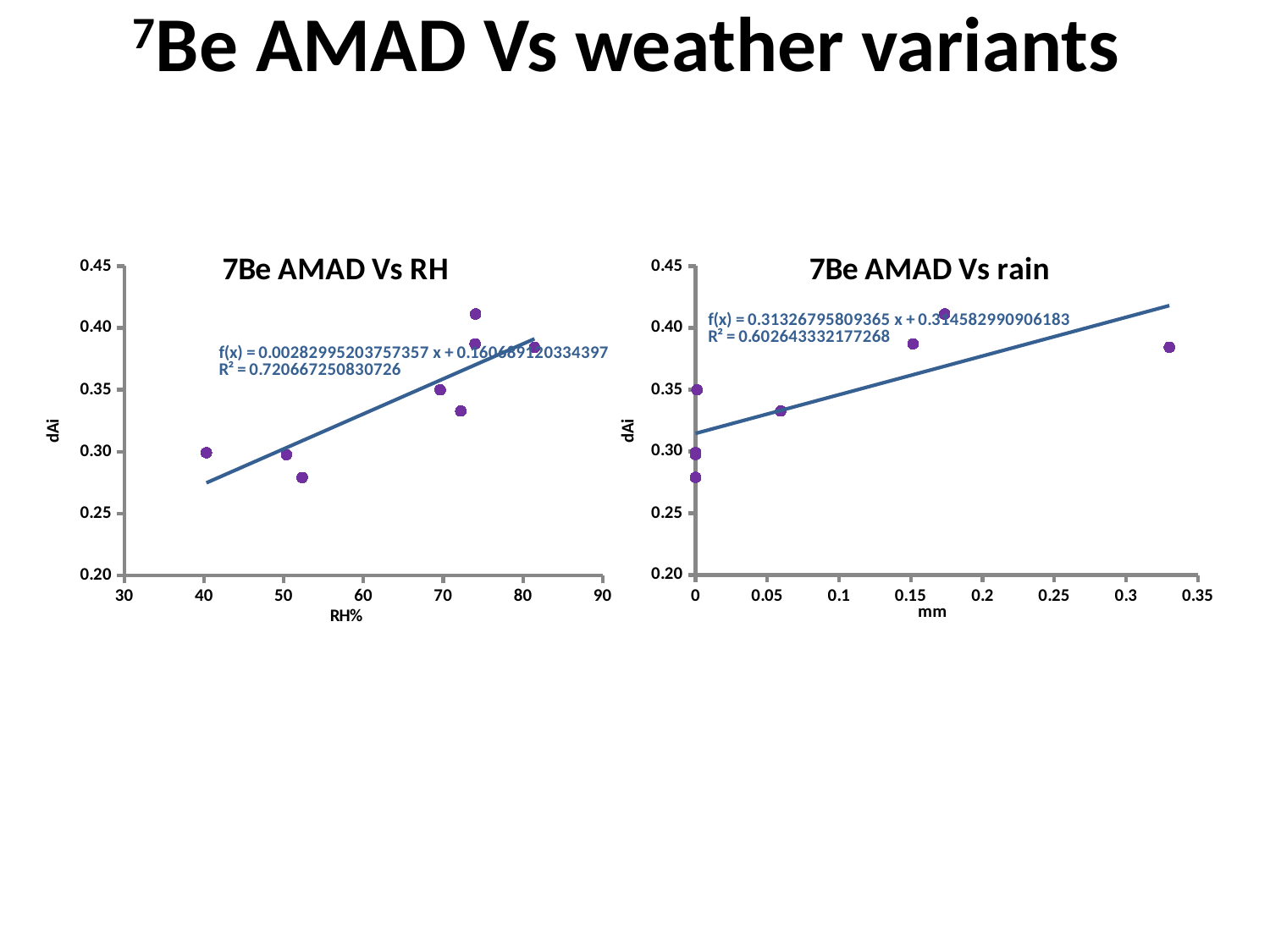
How many data points are plotted in the '7Be AMAD Vs RH' chart? 8 In the '7Be AMAD Vs RH' chart, what is the slope (coefficient of x) in the printed trendline equation? 0.00282995203757357 In the '7Be AMAD Vs RH' chart, is the dAi value of the point at about 40 RH% greater or less than 0.35? less In the '7Be AMAD Vs rain' chart, what is the slope (coefficient of x) in the printed trendline equation? 0.31326795809365 What type of chart is the '7Be AMAD Vs RH' chart? Scatter chart In the '7Be AMAD Vs RH' chart, is the highest plotted dAi value greater or less than 0.40? greater In the '7Be AMAD Vs rain' chart, does the trendline rise or fall as mm increases? Rises In the '7Be AMAD Vs rain' chart, what is the R² value printed on the chart? 0.602643332177268 In the '7Be AMAD Vs rain' chart, is the dAi value of the point at about 0.33 mm greater or less than 0.35? greater In the '7Be AMAD Vs RH' chart, what is the R² value printed on the chart? 0.720667250830726 In the '7Be AMAD Vs RH' chart, does the trendline rise or fall as RH% increases? Rises What is the x-axis title of the '7Be AMAD Vs rain' chart? mm